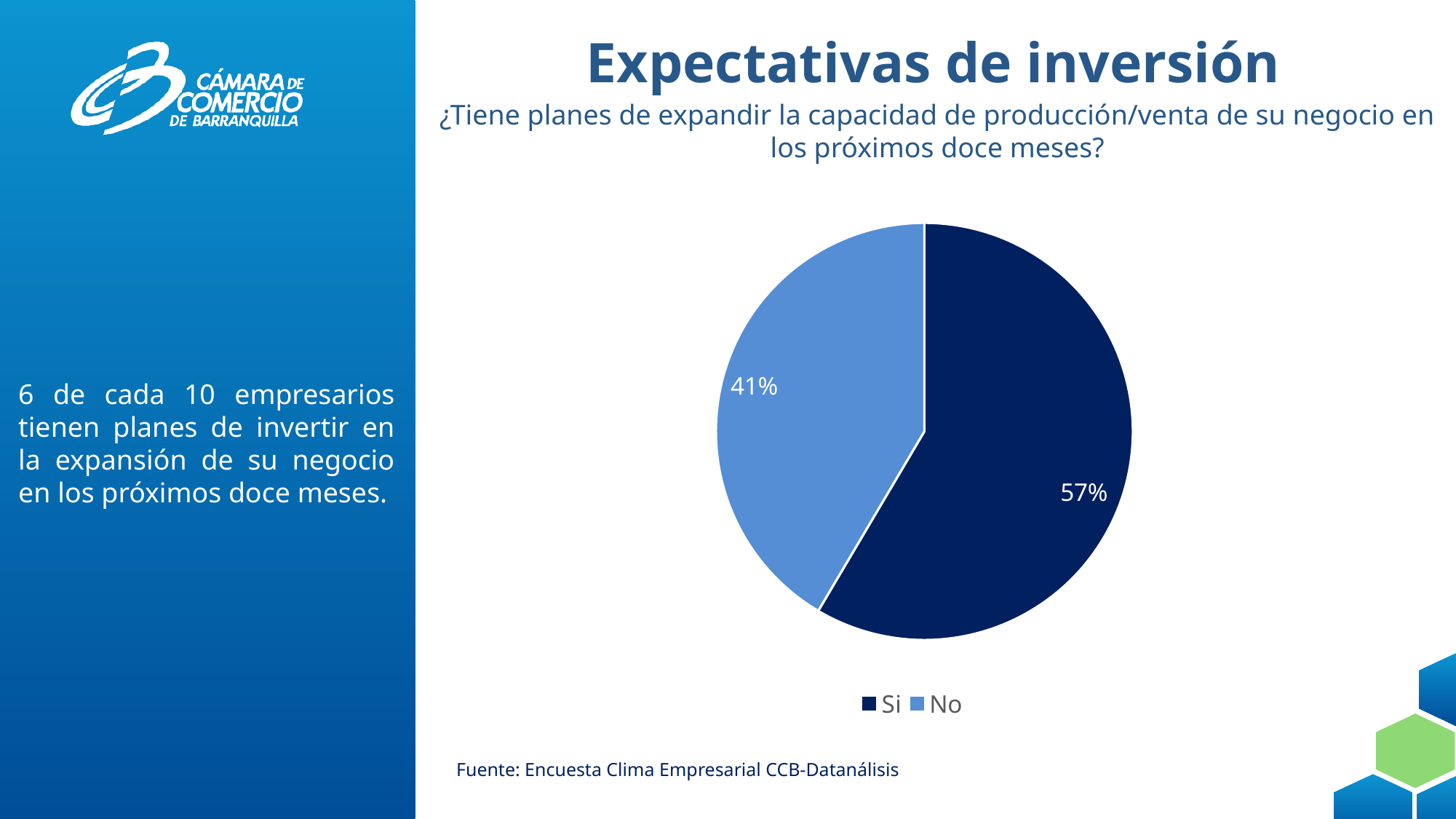
What is the main title of the slide above the chart? Expectativas de inversión Is the share for "Si" larger or smaller than the share for "No"? larger How many slices does the pie chart have? 2 What is the share of the pie represented by the "No" slice? 41% Which legend entry is shown in dark navy blue? Si What percentage of respondents answered "Si" in the pie chart? 57% How many entries does the chart legend list? 2 Which response has the larger share of the pie chart? Si What type of chart is shown on the slide? pie chart Which response has the smaller share of the pie chart? No What percentage of respondents answered "No" in the pie chart? 41% What is the difference in percentage points between the "Si" and "No" slices? 16